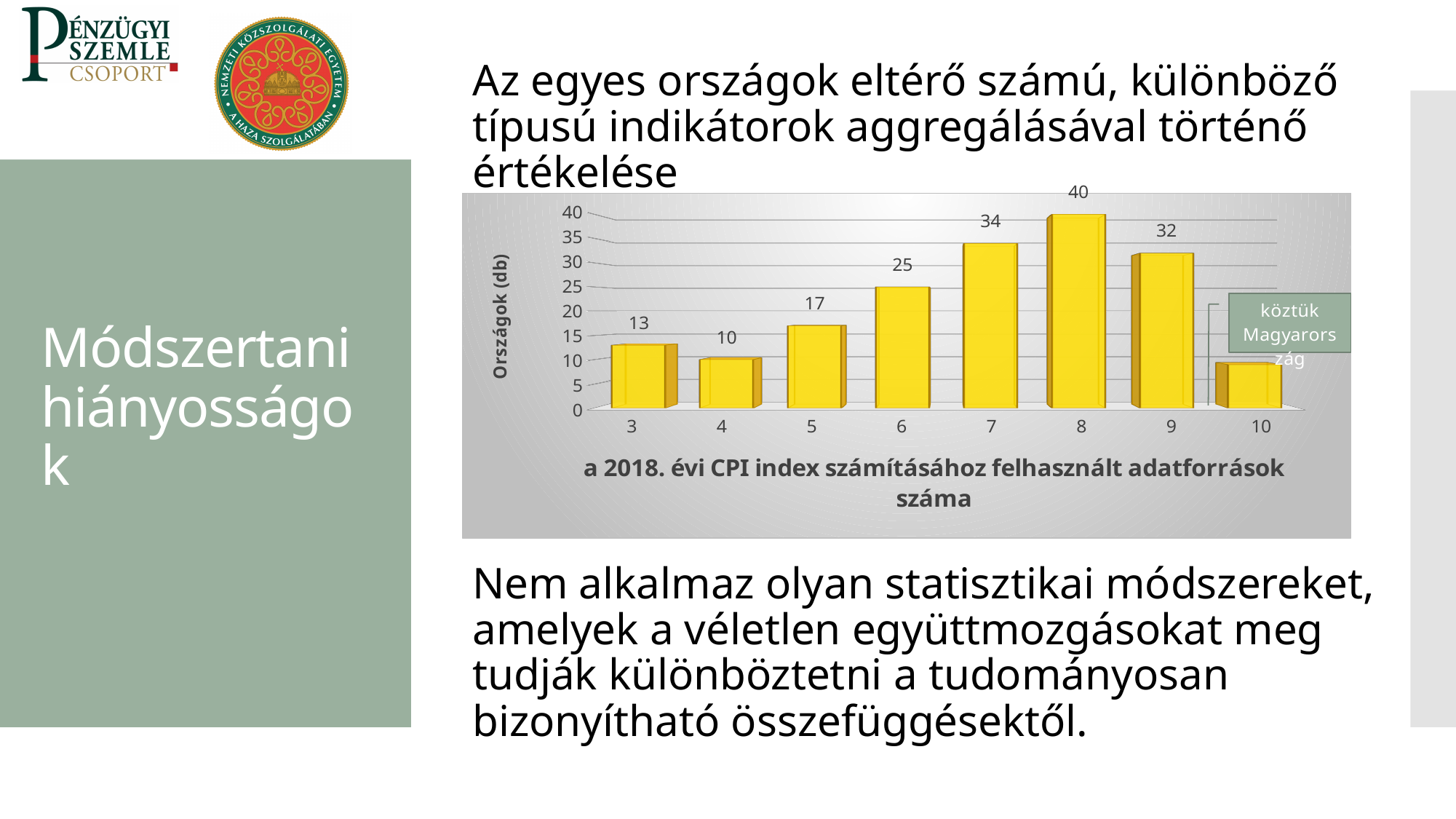
What is the value for 3 data sources? 13 What is the difference between the values for 8 and 9 data sources? 8 What kind of chart is shown on the slide? bar chart Which has a larger value, 4 data sources or 5 data sources? 5 How many countries used 8 data sources for the 2018 CPI index calculation? 40 What is the difference between the values for 7 and 6 data sources? 9 What is the title of the y axis? Országok (db) What is the value for 6 data sources? 25 Is the value for 10 data sources greater or less than 15? less How many categories are shown on the x axis? 8 Do the values rise or fall from 5 to 8 data sources? rise Which number of data sources has the highest number of countries? 8